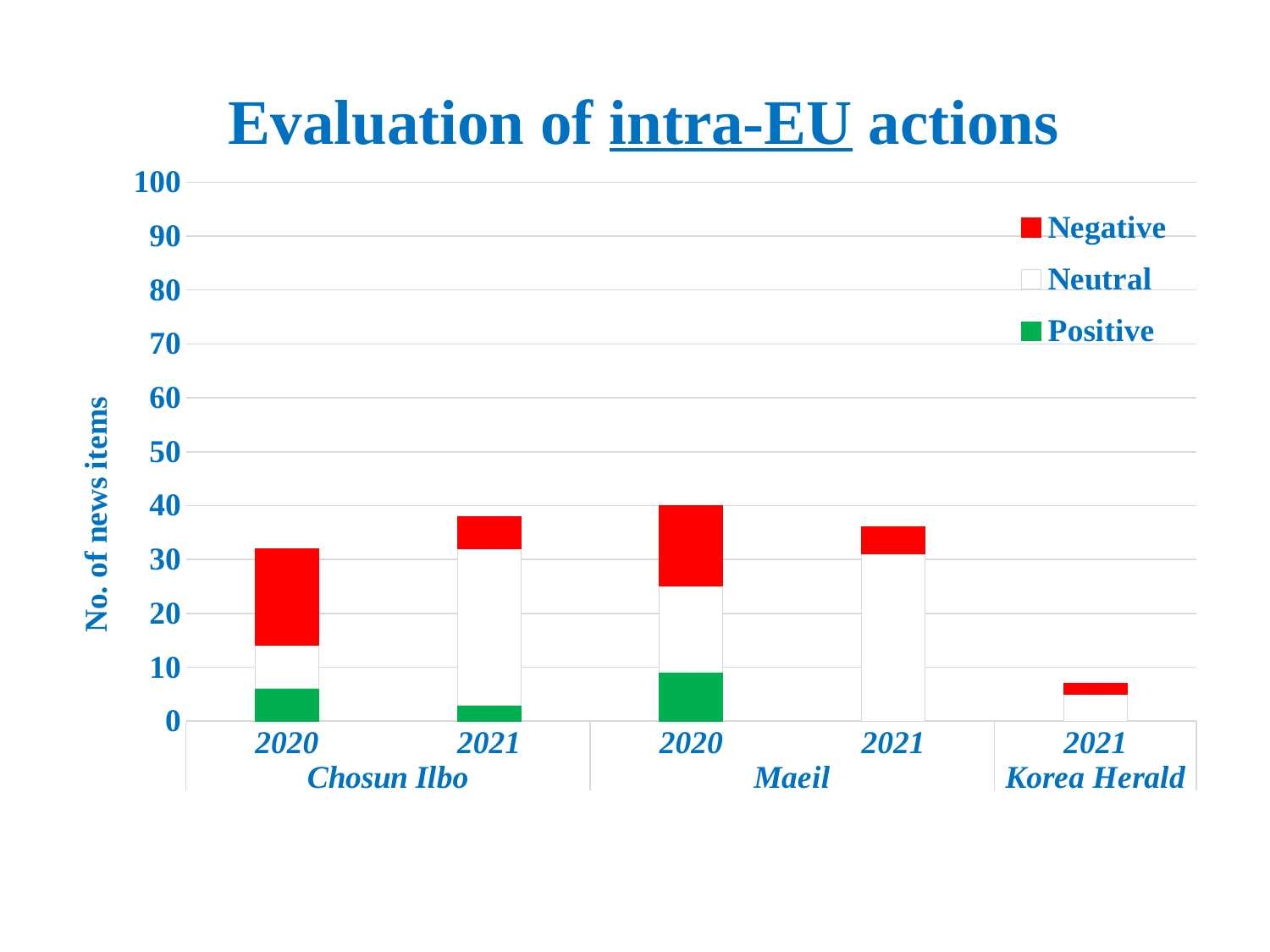
Which is larger, the total for Maeil 2020 or Maeil 2021? Maeil 2020 Is the total for Korea Herald 2021 greater or less than 10? less Which bar has the highest total number of news items? Maeil 2020 Which colour represents the Negative series in the legend? Red What kind of chart is shown on the slide? Stacked bar chart Which bar has the lowest total number of news items? Korea Herald 2021 How many bars are plotted in the chart? 5 Is the total for Chosun Ilbo 2020 greater or less than 30? greater Which is larger, the total for Chosun Ilbo 2020 or Chosun Ilbo 2021? Chosun Ilbo 2021 How many series does the legend list? 3 Is the total for Chosun Ilbo 2021 greater or less than 40? less What is the title of the chart's vertical axis? No. of news items